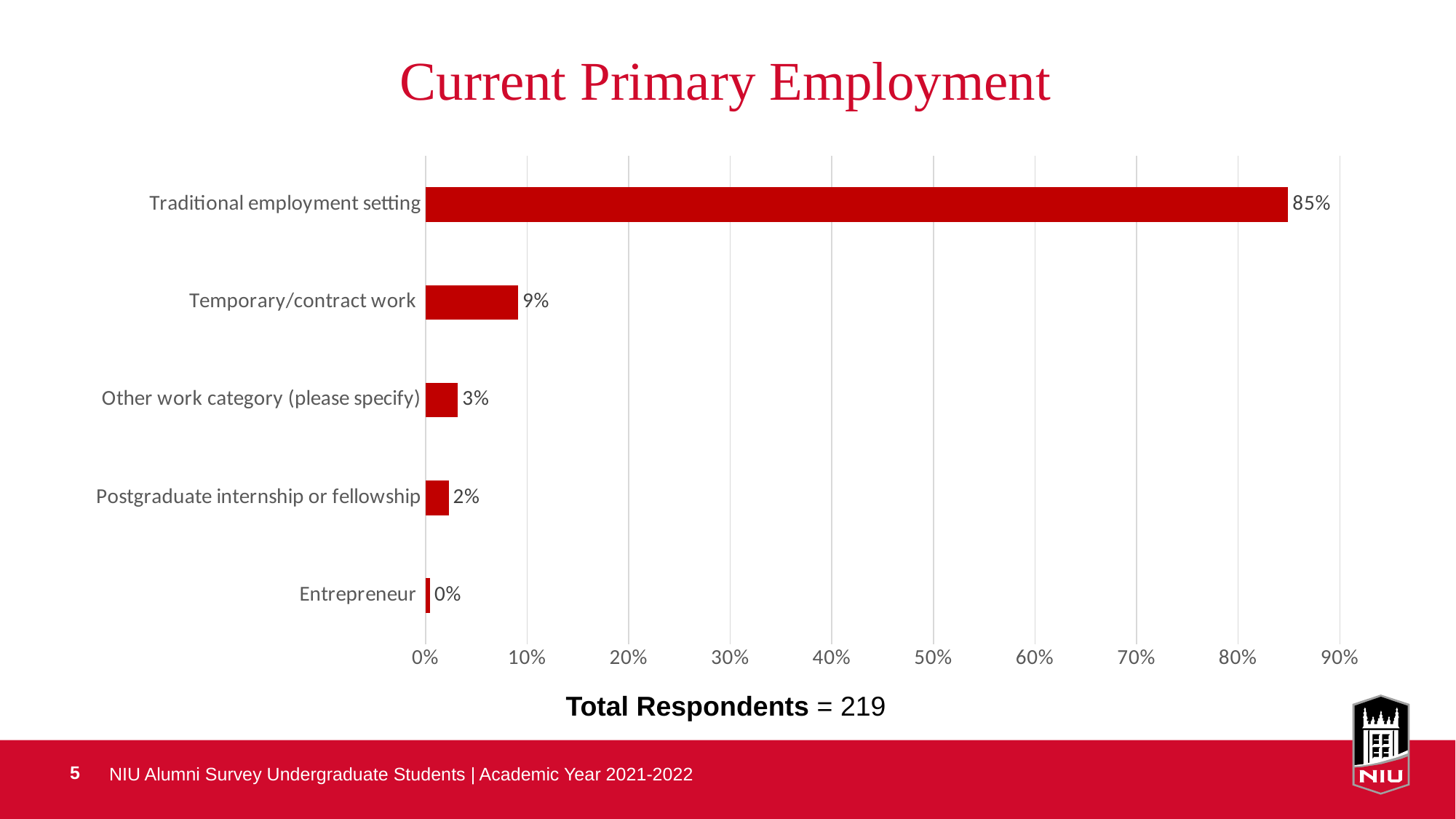
Which category has the highest value? Traditional employment setting What is the difference between the values for Traditional employment setting and Temporary/contract work? 76% What percentage of respondents reported a traditional employment setting as their current primary employment? 85% Which category has the lowest value? Entrepreneur What is the value for Postgraduate internship or fellowship? 2% What kind of chart is shown on the slide? Bar chart What percentage is shown for Other work category (please specify)? 3% What is the value shown for Temporary/contract work? 9% Which is larger, the value for Other work category (please specify) or Postgraduate internship or fellowship? Other work category (please specify) How many categories are shown in the chart? 5 What percentage is shown for Entrepreneur? 0% What is the total number of respondents stated below the chart? 219